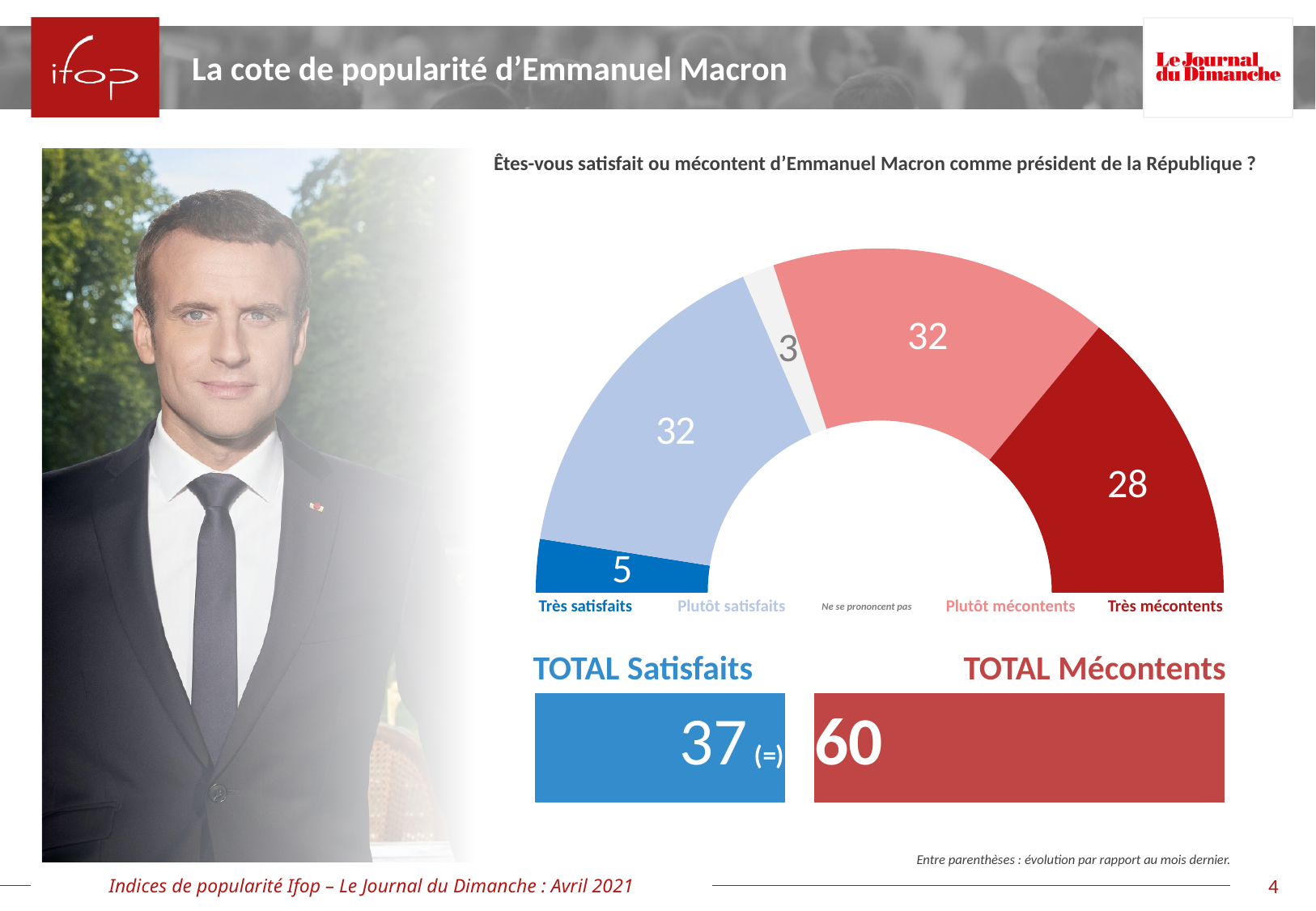
What value is shown for "Plutôt satisfaits"? 32 What value is shown for "Ne se prononcent pas"? 3 What value is shown for "Très satisfaits"? 5 What kind of chart is shown? Half-doughnut (semi-circle) chart What value is shown for "Très mécontents"? 28 What is the difference between "Très mécontents" and "Très satisfaits"? 23 What colour is the "Très mécontents" segment? Dark red Which is larger, "Très mécontents" or "Très satisfaits"? Très mécontents What is the value shown for "TOTAL Satisfaits"? 37 Which category has the lowest value? Ne se prononcent pas What is the value shown for "TOTAL Mécontents"? 60 How many categories are shown in the chart? 5